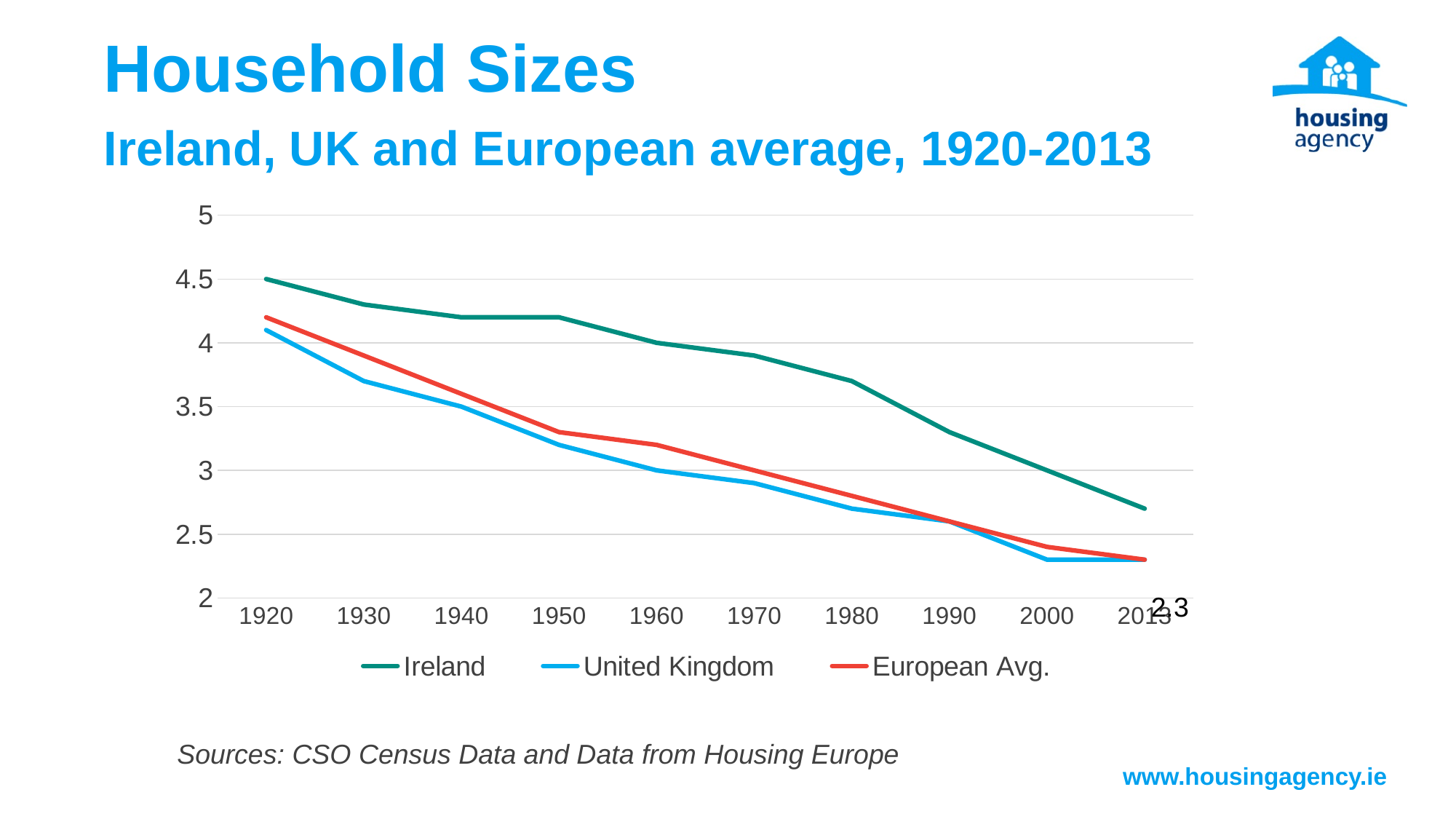
Does the Ireland line rise or fall from 1920 to 2013? fall What kind of chart is shown on the slide? line chart Is the value for United Kingdom in 2000 greater or less than 2.5? less Is the value for Ireland in 2013 greater or less than 3? less What colour is the Ireland line in the legend? green Which series has the highest value in 1920? Ireland Is the value for Ireland in 1920 greater or less than 4? greater How many series does the legend list? 3 Which series has the lowest value in 1940? United Kingdom How many years are marked along the x axis? 10 In 1980, which is larger: the value for Ireland or the value for United Kingdom? Ireland